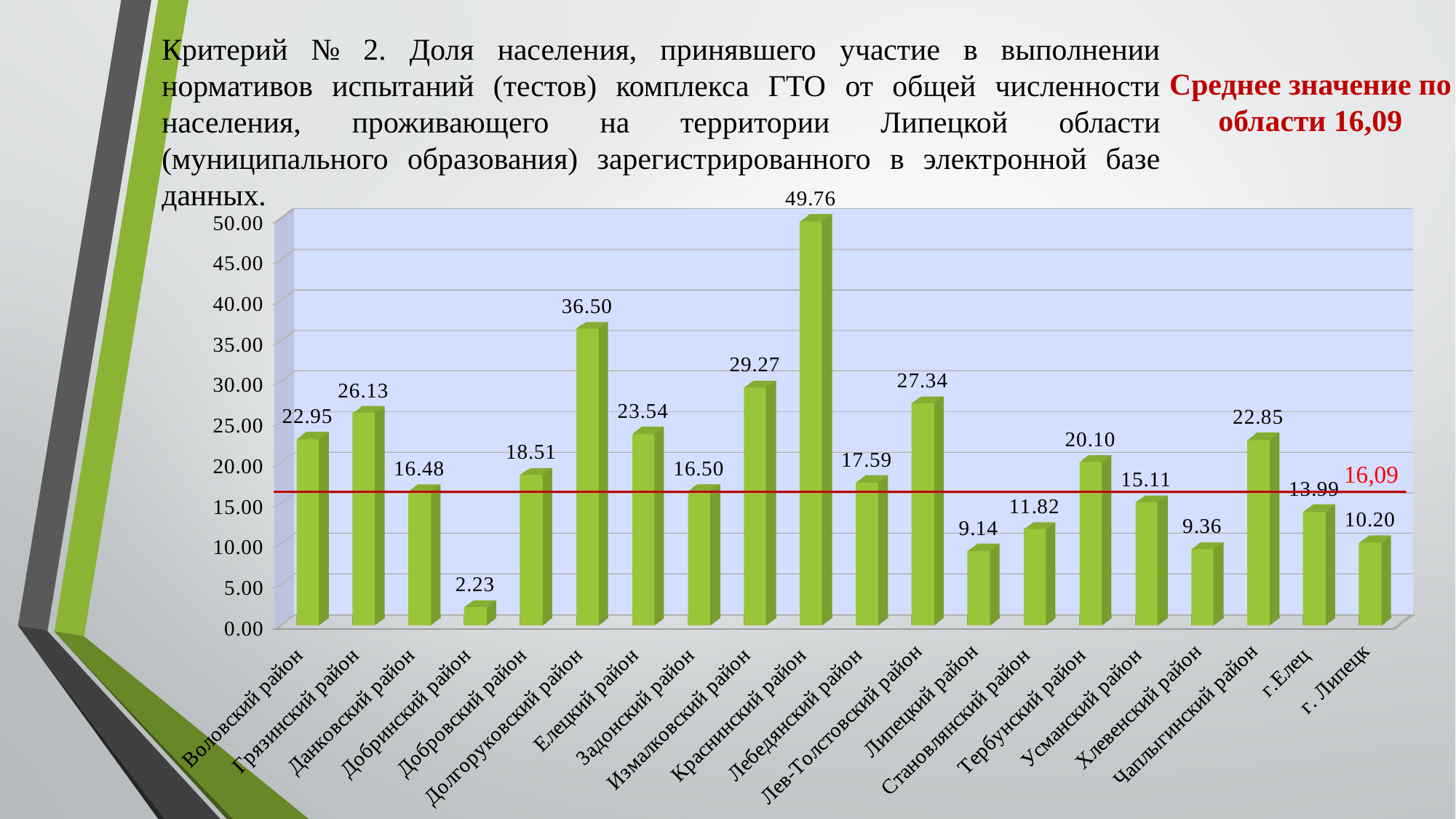
What is the value for г. Липецк? 10.20 Is the value for Тербунский район greater or less than 15.00? greater What is the value for Долгоруковский район? 36.50 What is the difference between the values for Краснинский район and Долгоруковский район? 13.26 Which category has the highest value? Краснинский район What is the value for Добринский район? 2.23 What is the value for Краснинский район? 49.76 What kind of chart is shown on the slide? bar chart Which category has the lowest value? Добринский район What value does the red horizontal line on the chart mark? 16,09 Which is larger, the value for Грязинский район or the value for Елецкий район? Грязинский район How many categories are shown on the x axis? 20